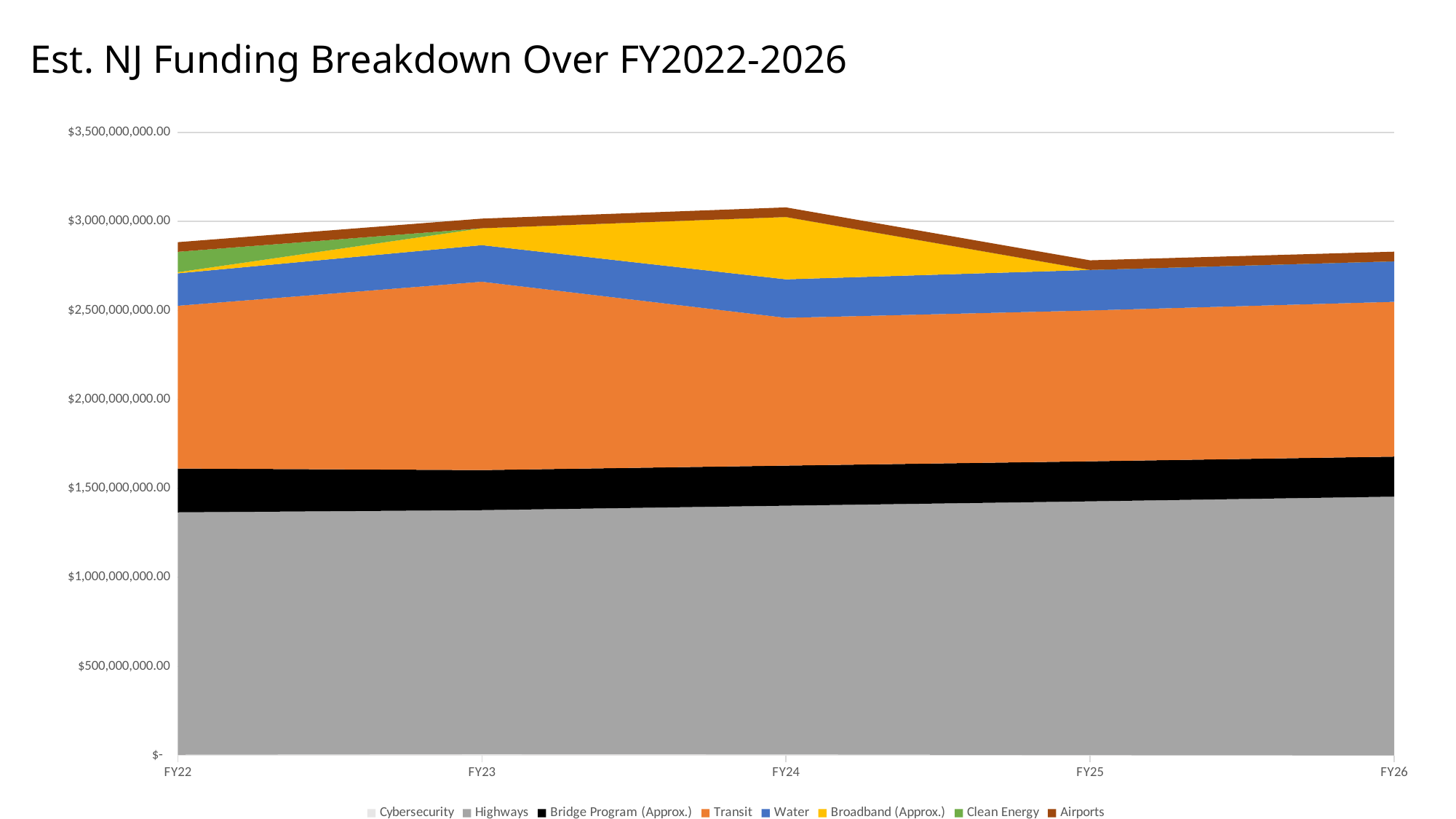
Which series is shown in gray at the bottom of the stack? Highways Which is larger, the total stacked funding for FY24 or for FY22? FY24 Is the total stacked funding for FY24 greater or less than $3,000,000,000.00? greater Is the total stacked funding for FY25 greater or less than $3,000,000,000.00? less Is the total stacked funding for FY22 greater or less than $3,000,000,000.00? less What is the title of the chart? Est. NJ Funding Breakdown Over FY2022-2026 Which fiscal year has the highest total stacked funding? FY24 How many fiscal years are plotted along the x axis? 5 Does the Highways series rise or fall from FY22 to FY26? rise How many series does the legend list? 8 What kind of chart is shown on the slide? Stacked area chart